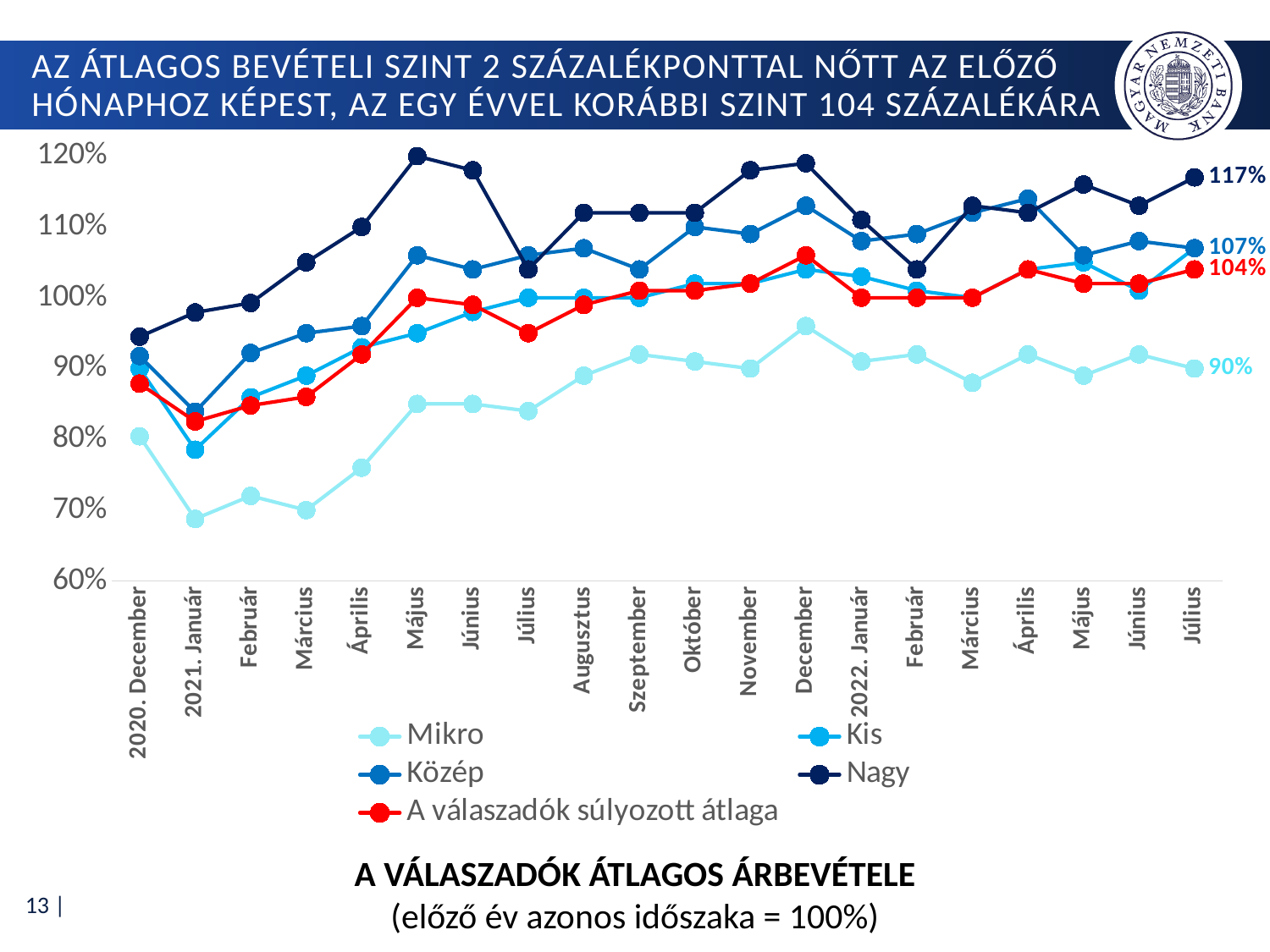
What is the difference between the Nagy and Mikro values in 2022 Július? 27 percentage points What is the value for Nagy in 2022 Július? 117% What is the value for Mikro in 2022 Július? 90% How many series does the legend list? 5 Which series has the highest value in 2022 Július? Nagy Is the value for Nagy in 2021 Május greater or less than 110%? greater How many months are plotted along the x axis? 20 Which is larger in 2021 Május, the value for Nagy or the value for Mikro? Nagy Which legend entry is drawn in red? A válaszadók súlyozott átlaga Which series has the lowest value in 2022 Július? Mikro What kind of chart is shown on the slide? line chart What is the value for A válaszadók súlyozott átlaga in 2022 Július? 104%